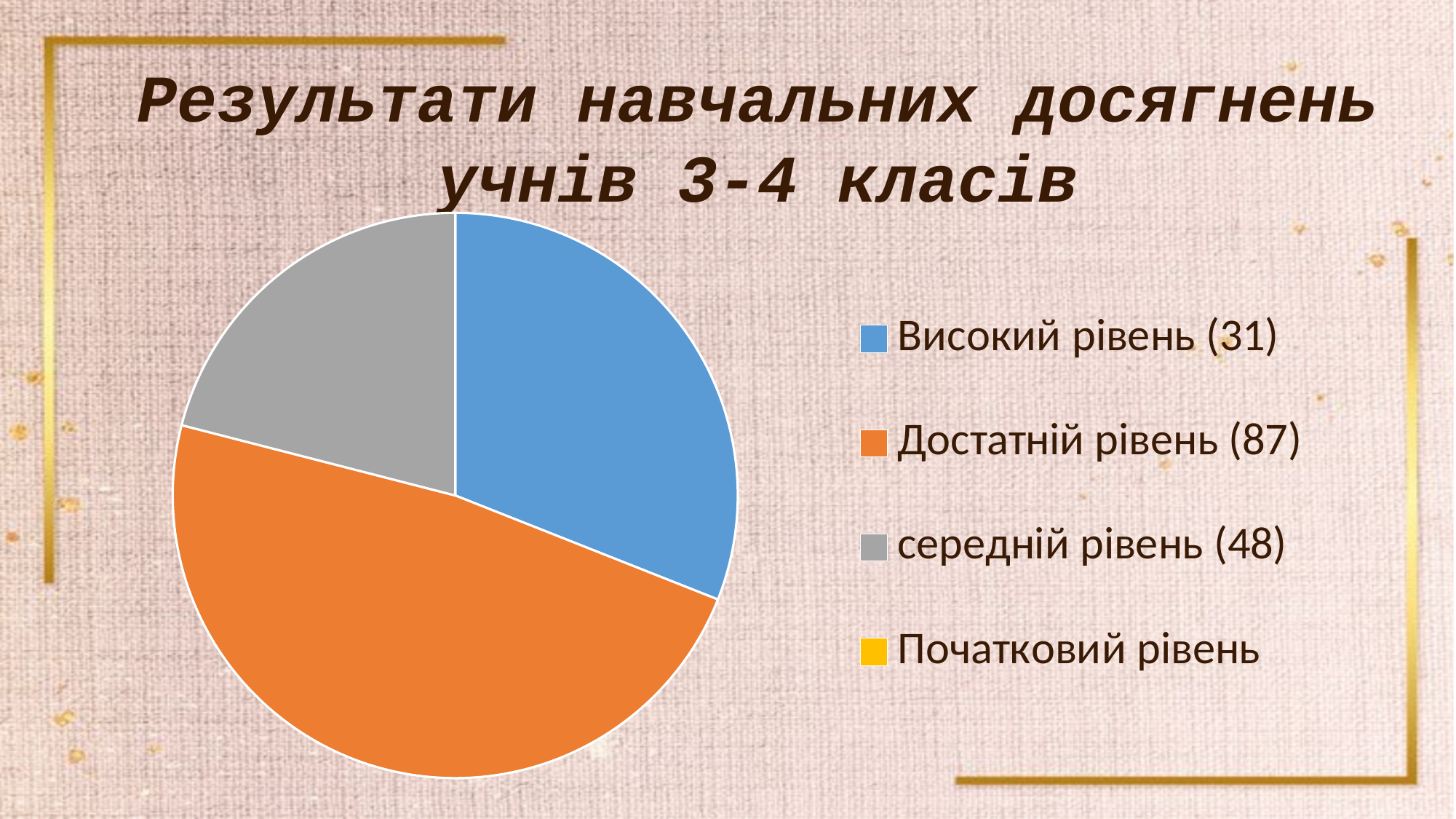
What is the value for Високий рівень? 31 Which category has the largest slice of the pie? Достатній рівень What is the difference between the values for Достатній рівень and Високий рівень? 56 What is the value for середній рівень? 48 How many categories does the legend list? 4 What colour is the slice for Достатній рівень? orange What kind of chart is shown on the slide? pie chart What is the difference between the values for Достатній рівень and середній рівень? 39 What is the value for Достатній рівень? 87 What is the difference between the values for середній рівень and Високий рівень? 17 Which category has the lowest value printed in the legend? Високий рівень